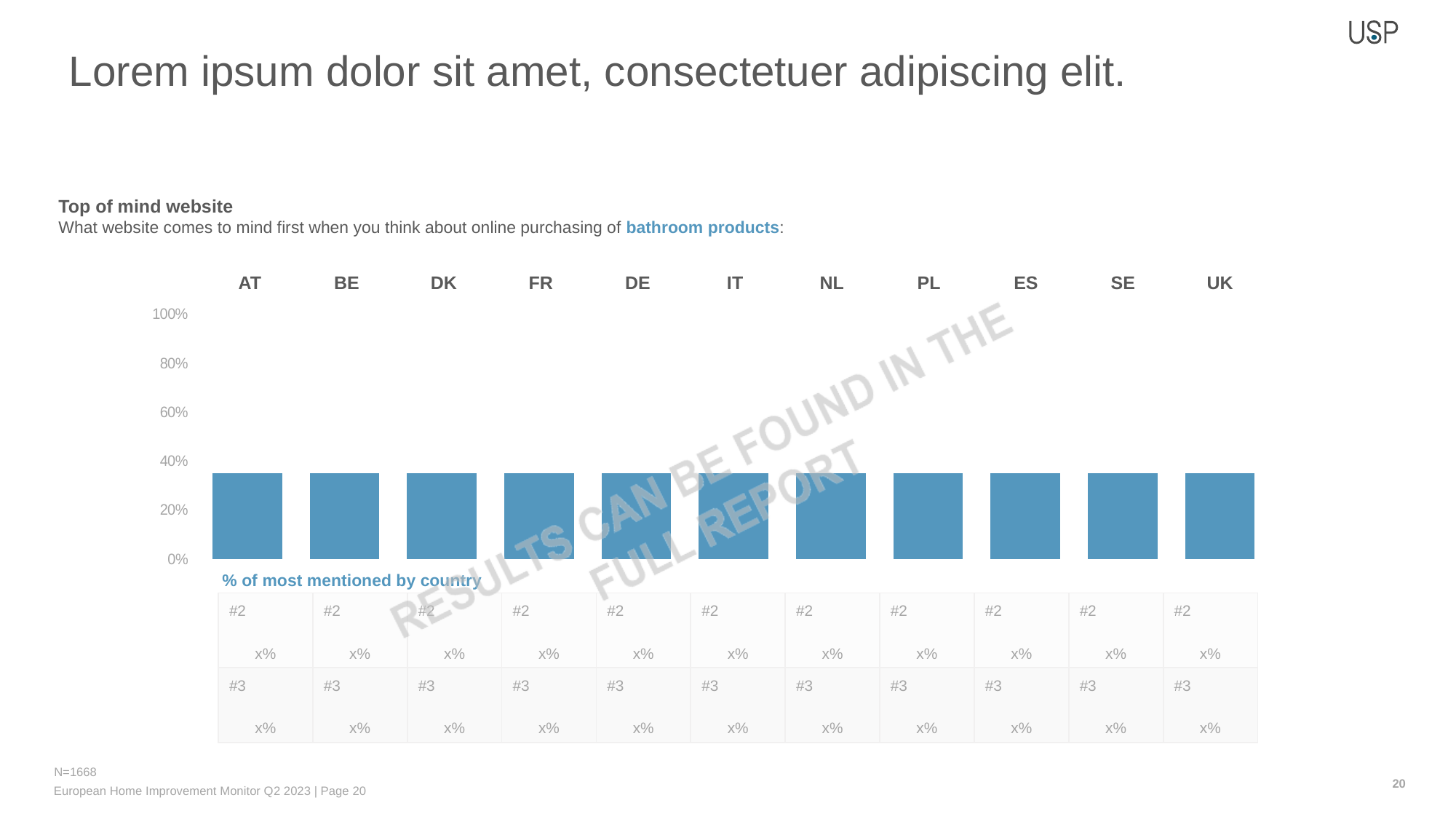
Is the value for UK greater or less than 20%? greater How many countries are shown on the x axis of the chart? 11 What is the highest value shown on the chart's vertical axis? 100% Which country label appears first (leftmost) on the chart's x axis? AT Is the value for DE greater or less than 60%? less Is the value for NL greater or less than 20%? greater What kind of chart is shown on the slide? bar chart What is the heading of the chart section above the question text? Top of mind website Do the bar values rise, fall, or stay roughly flat from AT to UK? stay roughly flat